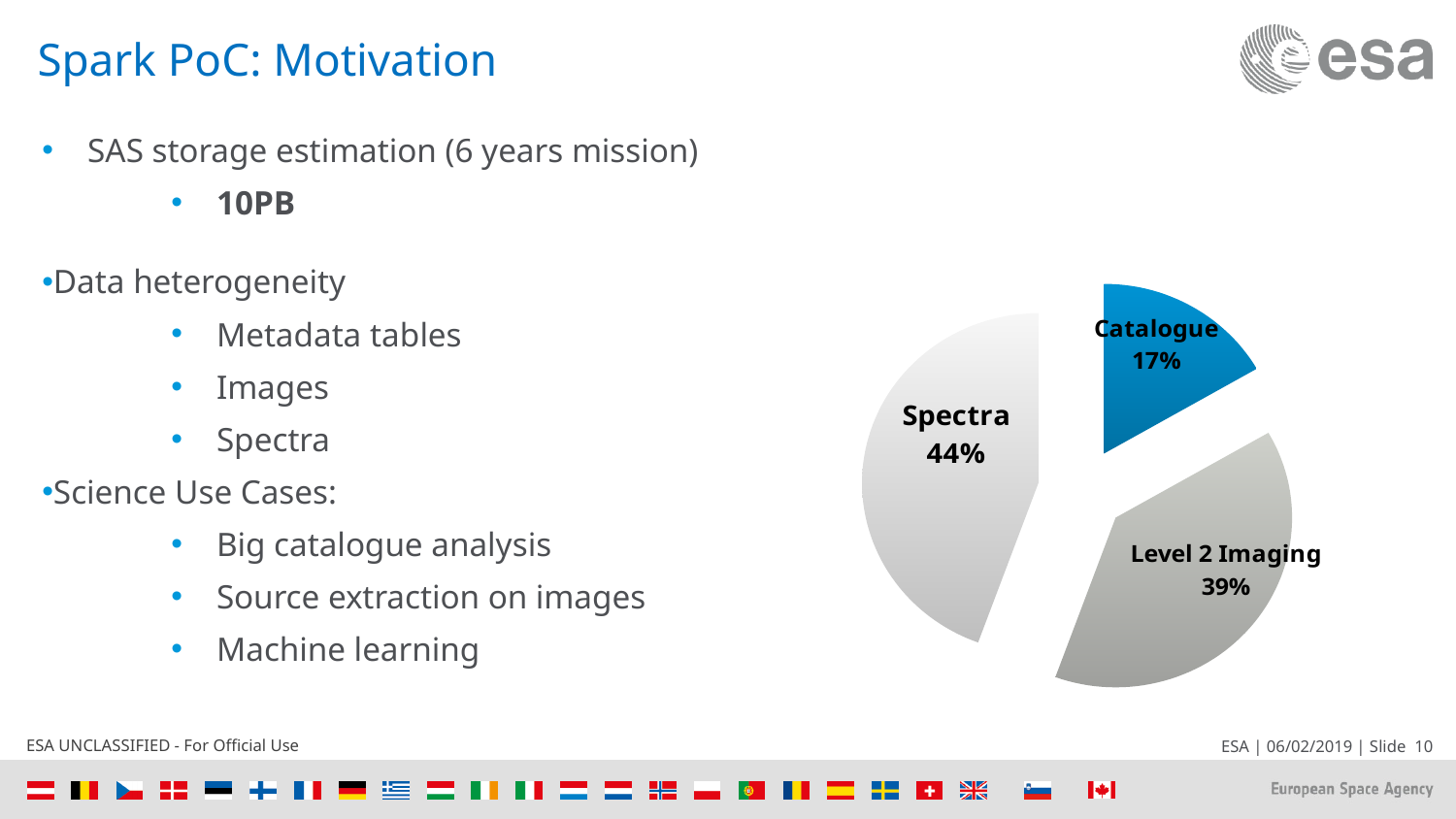
What kind of chart is shown on the slide? Pie chart How many slices does the pie chart have? 3 Which is larger, the Catalogue slice or the Level 2 Imaging slice? Level 2 Imaging Which slice of the pie chart is coloured blue? Catalogue Which is larger, the Spectra slice or the Level 2 Imaging slice? Spectra Which slice of the pie chart is the smallest? Catalogue What share of the pie chart does Level 2 Imaging account for? 39% Which slice of the pie chart is the largest? Spectra What share of the pie chart does Spectra account for? 44% What is the difference in percentage points between the Spectra and Catalogue slices? 27 What is the difference in percentage points between the Level 2 Imaging and Catalogue slices? 22 What share of the pie chart does Catalogue account for? 17%